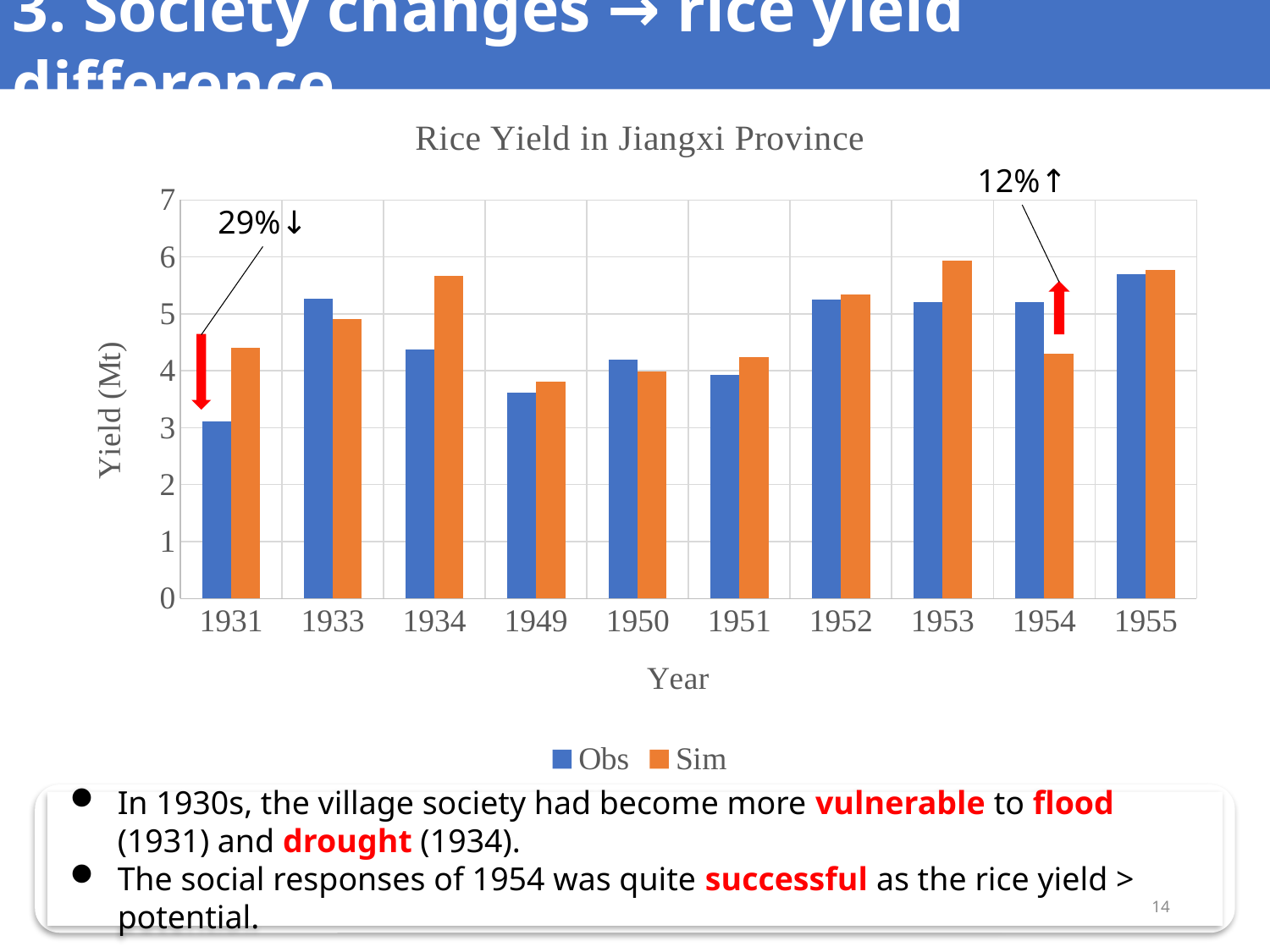
How many series does the legend list in the Rice Yield in Jiangxi Province chart? 2 How many years are shown on the x axis of the chart? 10 Is the Obs value for 1931 greater or less than 4? less Is the Sim value for 1934 greater or less than 5? greater What is the y-axis label of the chart? Yield (Mt) In 1954, which is larger, the Obs value or the Sim value? Obs In 1931, which is larger, the Obs value or the Sim value? Sim Is the Sim value for 1953 greater or less than 5? greater Which year has the lowest Obs value? 1931 What is the title of the chart? Rice Yield in Jiangxi Province What type of chart is shown on the slide? Bar chart